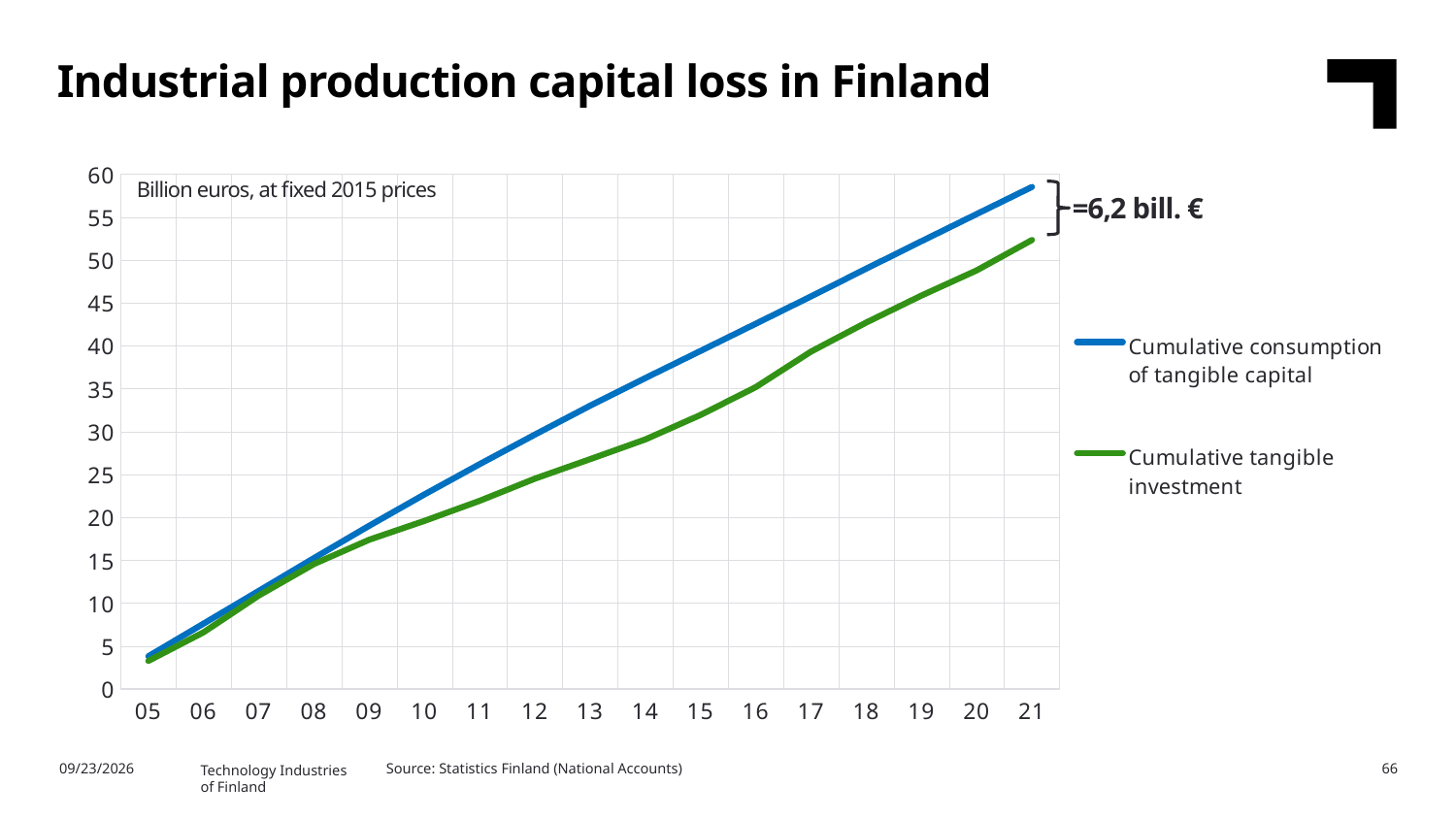
Do the values for Cumulative tangible investment rise or fall from 05 to 21? rise Is the value for Cumulative tangible investment in 21 greater or less than 55? less How many series does the legend list? 2 What kind of chart is shown on the slide? line chart Do the values for Cumulative consumption of tangible capital rise or fall from 05 to 21? rise How many years are shown on the x axis? 17 What unit note is printed inside the chart area? Billion euros, at fixed 2015 prices What is the title of the slide? Industrial production capital loss in Finland Is the value for Cumulative tangible investment in 13 greater or less than 30? less What gap between the two lines in 21 is labelled on the chart? =6,2 bill. € Is the value for Cumulative consumption of tangible capital in 21 greater or less than 55? greater In 21, which series is higher: Cumulative consumption of tangible capital or Cumulative tangible investment? Cumulative consumption of tangible capital